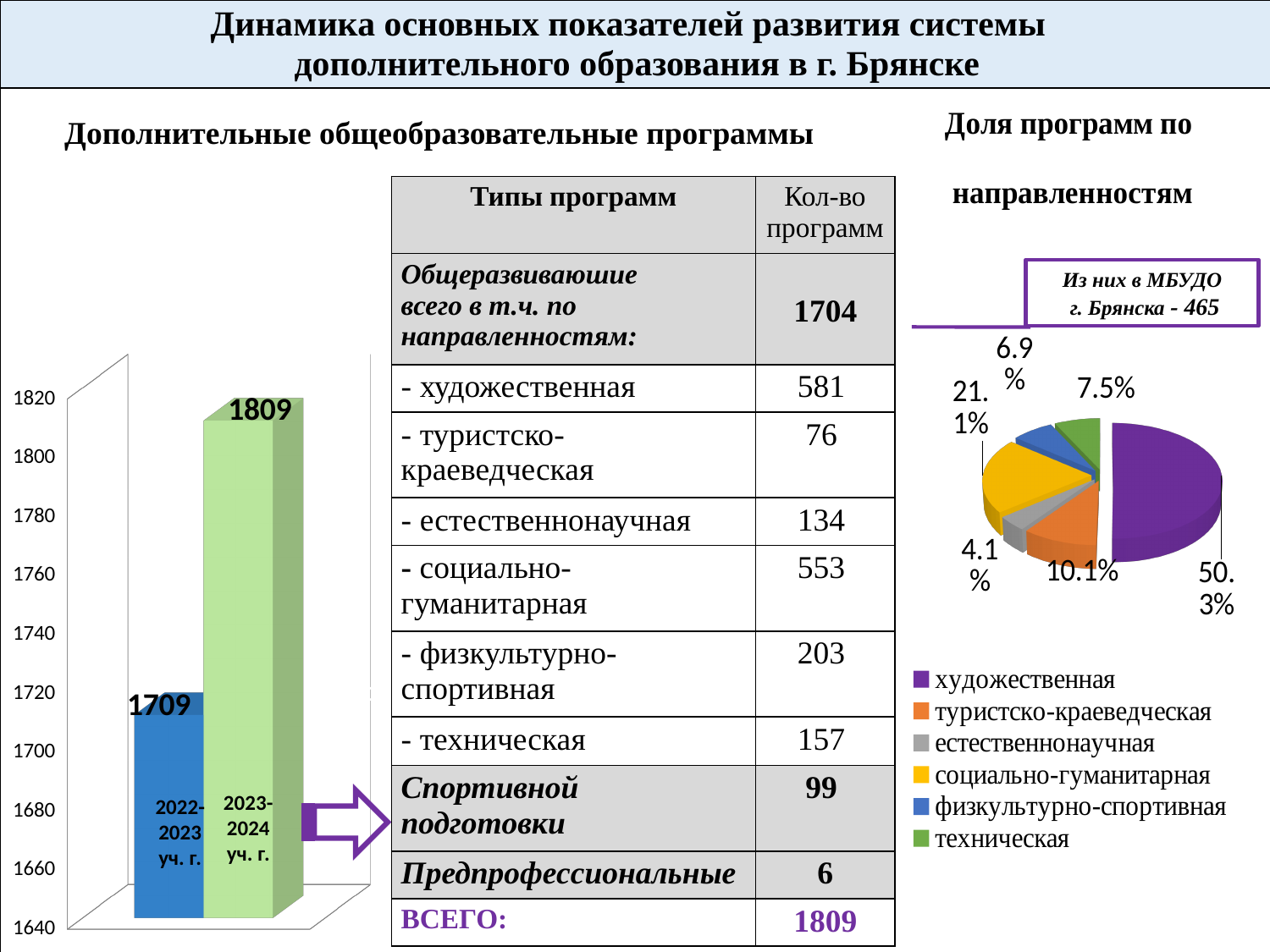
In the pie chart 'Доля программ по направленностям', what share does социально-гуманитарная have? 21.1% In the bar chart on the left, what is the value for the 2022-2023 academic year? 1709 In the pie chart 'Доля программ по направленностям', which category has the largest slice? художественная In the bar chart on the left, what is the value for the 2023-2024 academic year? 1809 In the bar chart on the left, what is the difference between the 2023-2024 value and the 2022-2023 value? 100 In the pie chart 'Доля программ по направленностям', what colour is the художественная slice? purple In the bar chart on the left, which academic year has the higher value? 2023-2024 уч. г. How many categories does the legend of the pie chart 'Доля программ по направленностям' list? 6 How many bars are plotted in the bar chart on the left? 2 In the bar chart on the left, do the values rise or fall from 2022-2023 to 2023-2024? rise What kind of chart is the chart on the left of the slide? bar chart In the pie chart 'Доля программ по направленностям', what share does художественная have? 50.3%